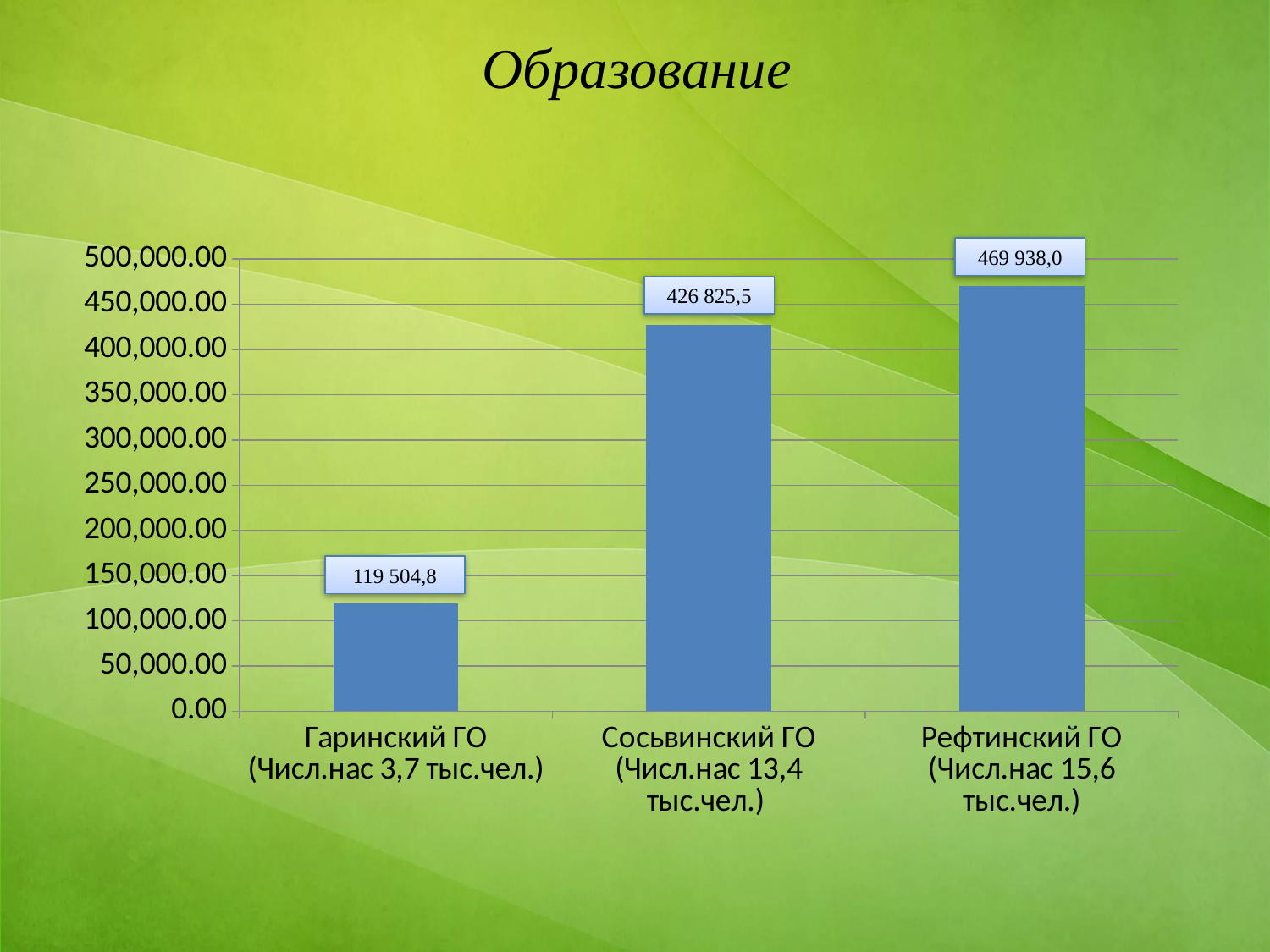
What kind of chart is shown on the slide? bar chart What is the value for Рефтинский ГО? 469 938,0 What is the difference between the values for Рефтинский ГО and Сосьвинский ГО? 43 112,5 What is the value for Сосьвинский ГО? 426 825,5 Which category has the highest value? Рефтинский ГО Is the value for Гаринский ГО greater or less than 150,000.00? less How many categories are shown in the chart? 3 Which is larger, the value for Сосьвинский ГО or the value for Гаринский ГО? Сосьвинский ГО What is the title of the slide? Образование What is the value for Гаринский ГО? 119 504,8 What is the difference between the values for Сосьвинский ГО and Гаринский ГО? 307 320,7 Which category has the lowest value? Гаринский ГО